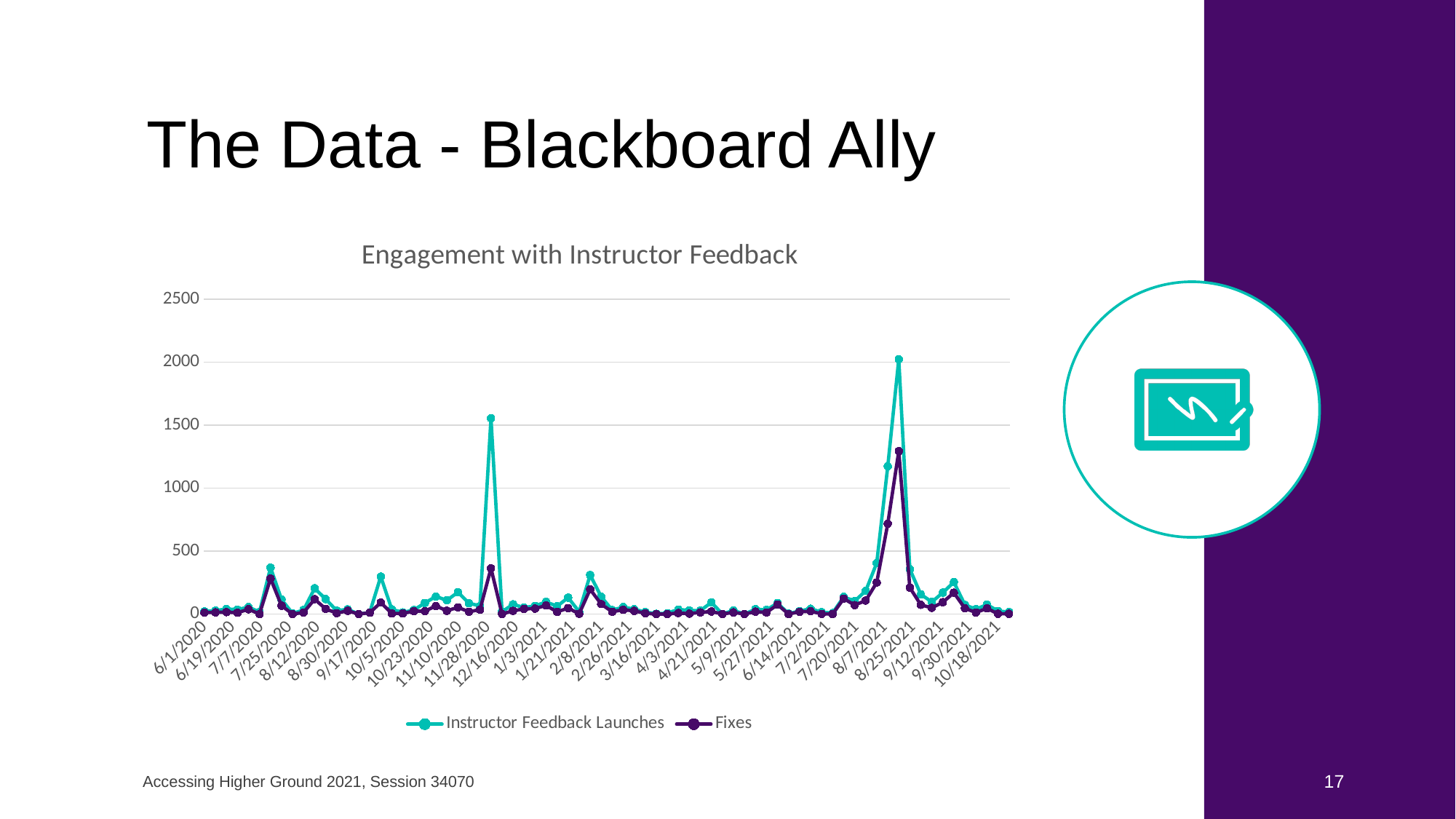
At the peak around 8/25/2021, which series has the larger value, Instructor Feedback Launches or Fixes? Instructor Feedback Launches What kind of chart is shown on the slide? line chart At 11/28/2020, which series has the larger value, Instructor Feedback Launches or Fixes? Instructor Feedback Launches What is the highest value shown on the vertical axis of the chart? 2500 Is the value of Fixes at 11/28/2020 greater or less than 500? less Which series is drawn in purple in the chart? Fixes Is the highest value of Fixes greater or less than 1000? greater Is the highest value of Instructor Feedback Launches greater or less than 1500? greater How many series does the legend of the chart list? 2 What is the title of the chart? Engagement with Instructor Feedback